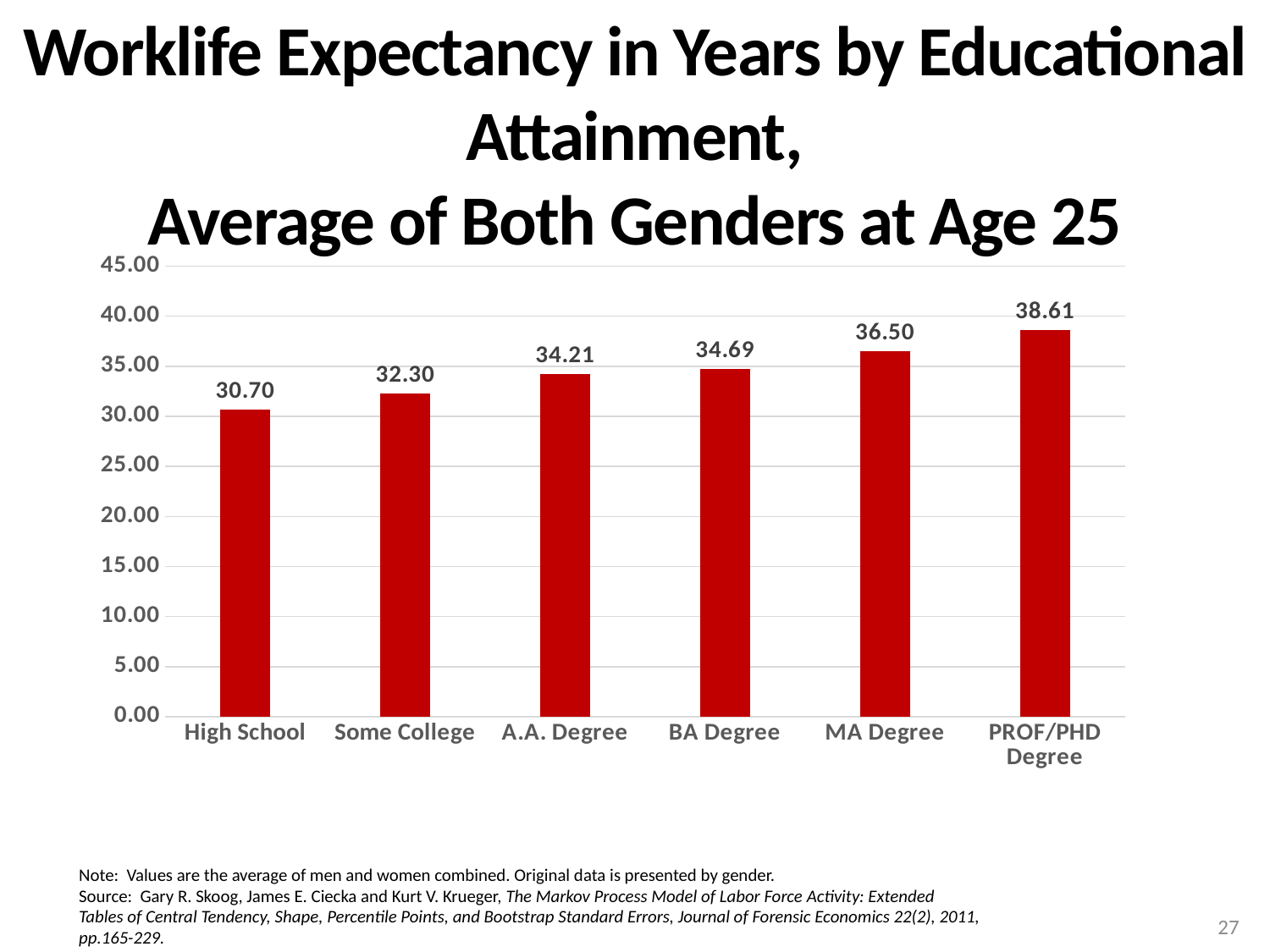
What is the worklife expectancy value for BA Degree? 34.69 Do the values rise or fall moving from High School to PROF/PHD Degree along the x axis? rise Which educational attainment category has the lowest worklife expectancy? High School Is the value for A.A. Degree greater or less than 35.00? less How many educational attainment categories are shown on the chart? 6 Which is larger, the value for Some College or the value for MA Degree? MA Degree What is the difference between the values for Some College and A.A. Degree? 1.91 What is the worklife expectancy value for MA Degree? 36.50 What is the worklife expectancy value for High School? 30.70 What is the difference between the values for PROF/PHD Degree and High School? 7.91 Which educational attainment category has the highest worklife expectancy? PROF/PHD Degree What kind of chart is shown on the slide? bar chart